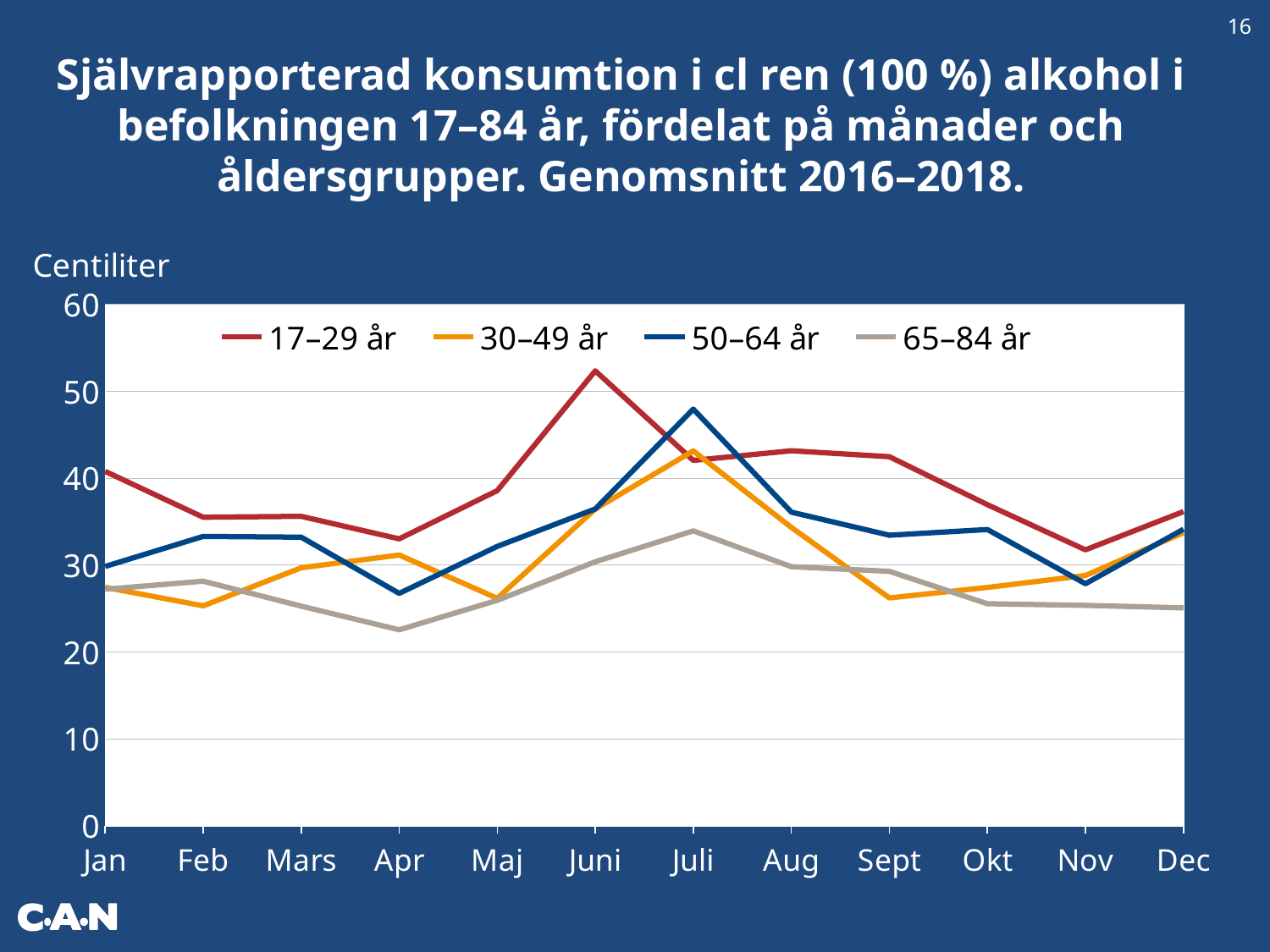
How many series does the legend list? 4 Is the value for 17–29 år in Juni greater or less than 50? greater Is the value for 65–84 år in Apr greater or less than 30? less In Jan, which series has the larger value: 17–29 år or 65–84 år? 17–29 år In which month does the 17–29 år series reach its highest value? Juni What kind of chart is shown on the slide? Line chart How many months are shown along the x axis? 12 In which month does the 65–84 år series reach its lowest value? Apr In Juli, which series has the larger value: 50–64 år or 30–49 år? 50–64 år In which month does the 50–64 år series reach its highest value? Juli Does the 17–29 år series rise or fall from Juni to Nov? Fall What unit label is shown above the y axis? Centiliter